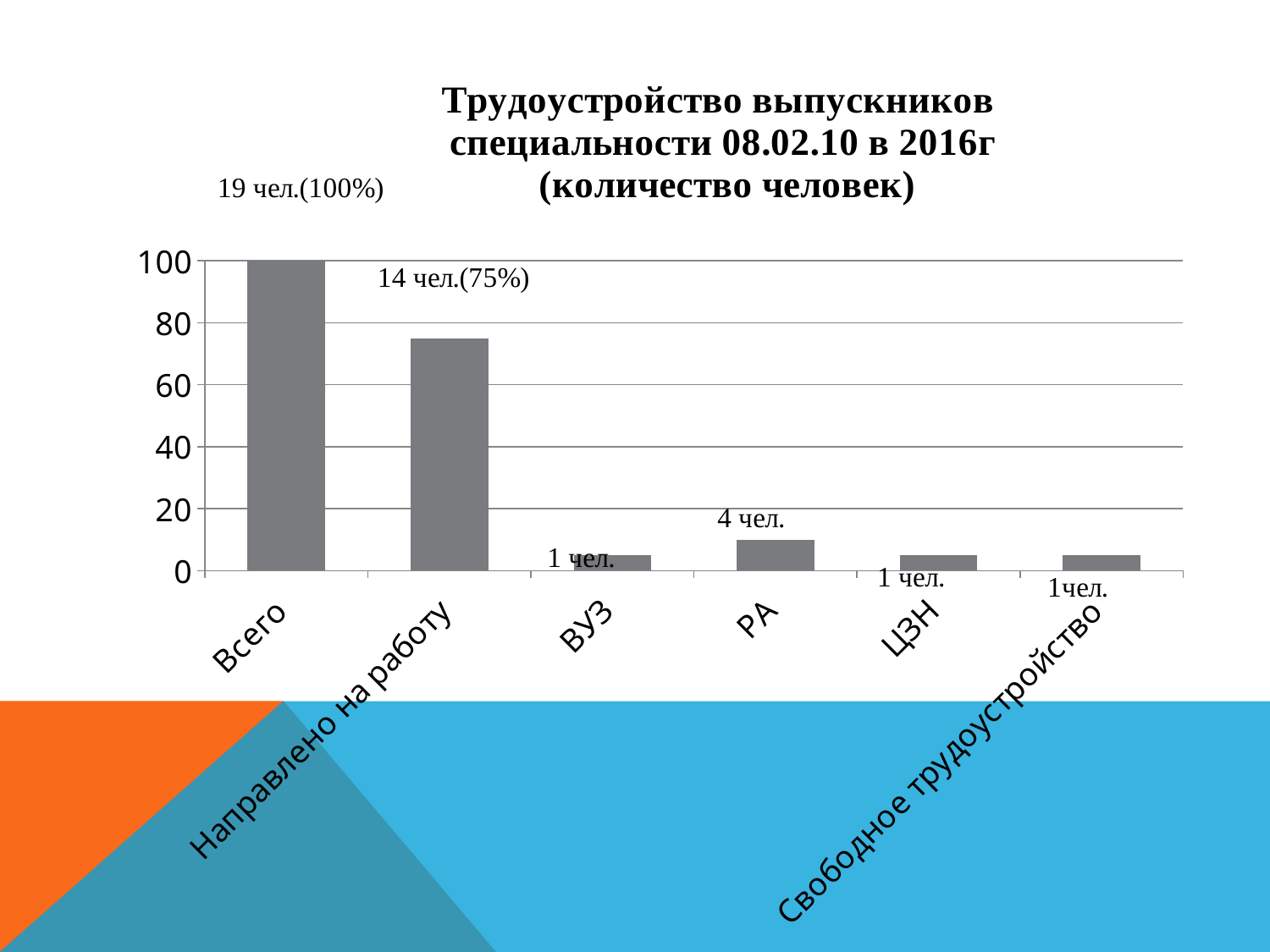
How many people are shown for РА according to the label on the chart? 4 чел. What label is printed above the bar for Всего? 19 чел.(100%) How many categories are shown on the x axis of the chart? 6 What kind of chart is shown on the slide? bar chart Is the bar for РА greater or less than 20 on the y axis? less Which bar is taller, Направлено на работу or РА? Направлено на работу What label is printed above the bar for Направлено на работу? 14 чел.(75%) What value does the bar for Всего reach on the y axis? 100 Is the bar for Направлено на работу greater or less than 60 on the y axis? greater Which category has the highest bar in the chart? Всего What is the title of the chart? Трудоустройство выпускников специальности 08.02.10 в 2016г (количество человек) How many people are shown for ВУЗ according to the label on the chart? 1 чел.